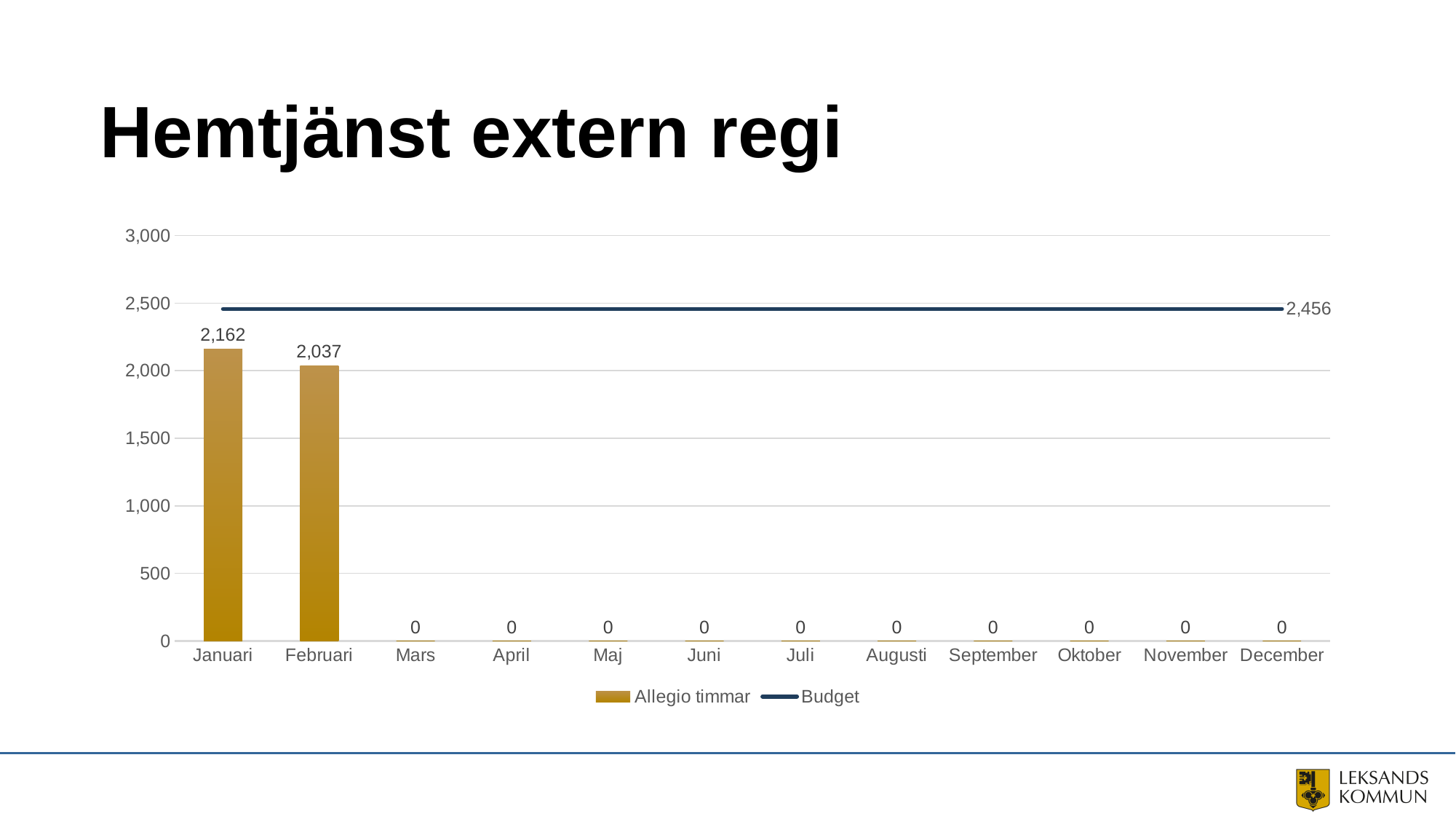
What is the difference between the Budget value and the Allegio timmar value for Januari? 294 Is the Allegio timmar value for Februari greater or less than 2,500? less What is the value of Allegio timmar for Mars? 0 What is the title of the slide containing the chart? Hemtjänst extern regi Which month has the highest Allegio timmar value? Januari What is the Budget value shown on the chart? 2,456 How many series does the legend list? 2 What is the difference between the Allegio timmar values for Januari and Februari? 125 How many months are shown on the x axis? 12 What is the value of Allegio timmar for Februari? 2,037 Which is larger, the Allegio timmar value for Januari or for Februari? Januari What is the value of Allegio timmar for Januari? 2,162